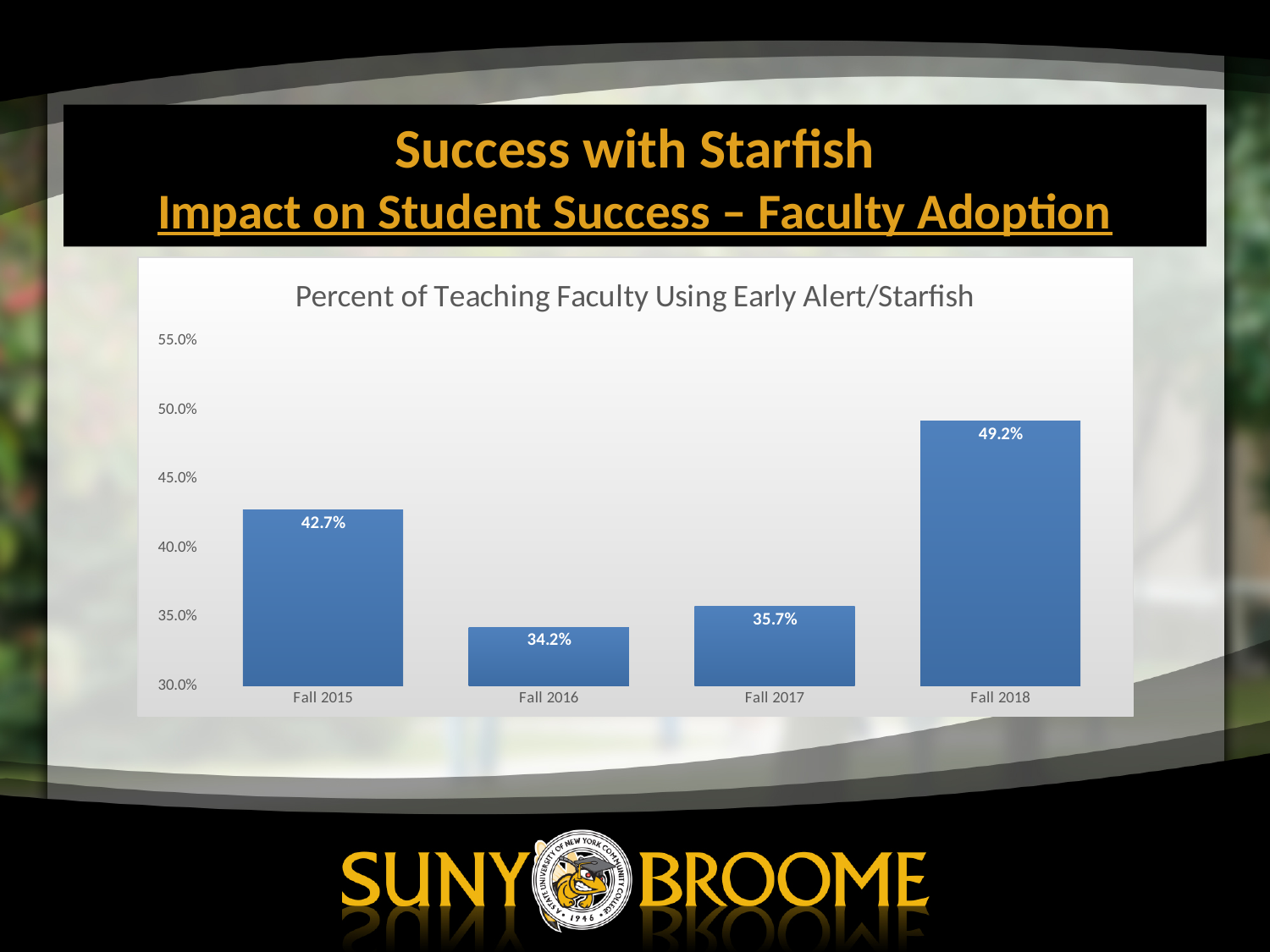
What is the difference between the values for Fall 2017 and Fall 2016? 1.5% What is the value for Fall 2018? 49.2% How many semesters are shown on the chart? 4 What is the difference between the values for Fall 2018 and Fall 2015? 6.5% What is the title of the chart? Percent of Teaching Faculty Using Early Alert/Starfish Which is larger, the value for Fall 2015 or the value for Fall 2017? Fall 2015 What kind of chart is shown on the slide? Bar chart Which semester has the highest percent of teaching faculty using Early Alert/Starfish? Fall 2018 Which semester has the lowest percent of teaching faculty using Early Alert/Starfish? Fall 2016 What is the value for Fall 2015? 42.7% What is the value for Fall 2017? 35.7% What is the value for Fall 2016? 34.2%